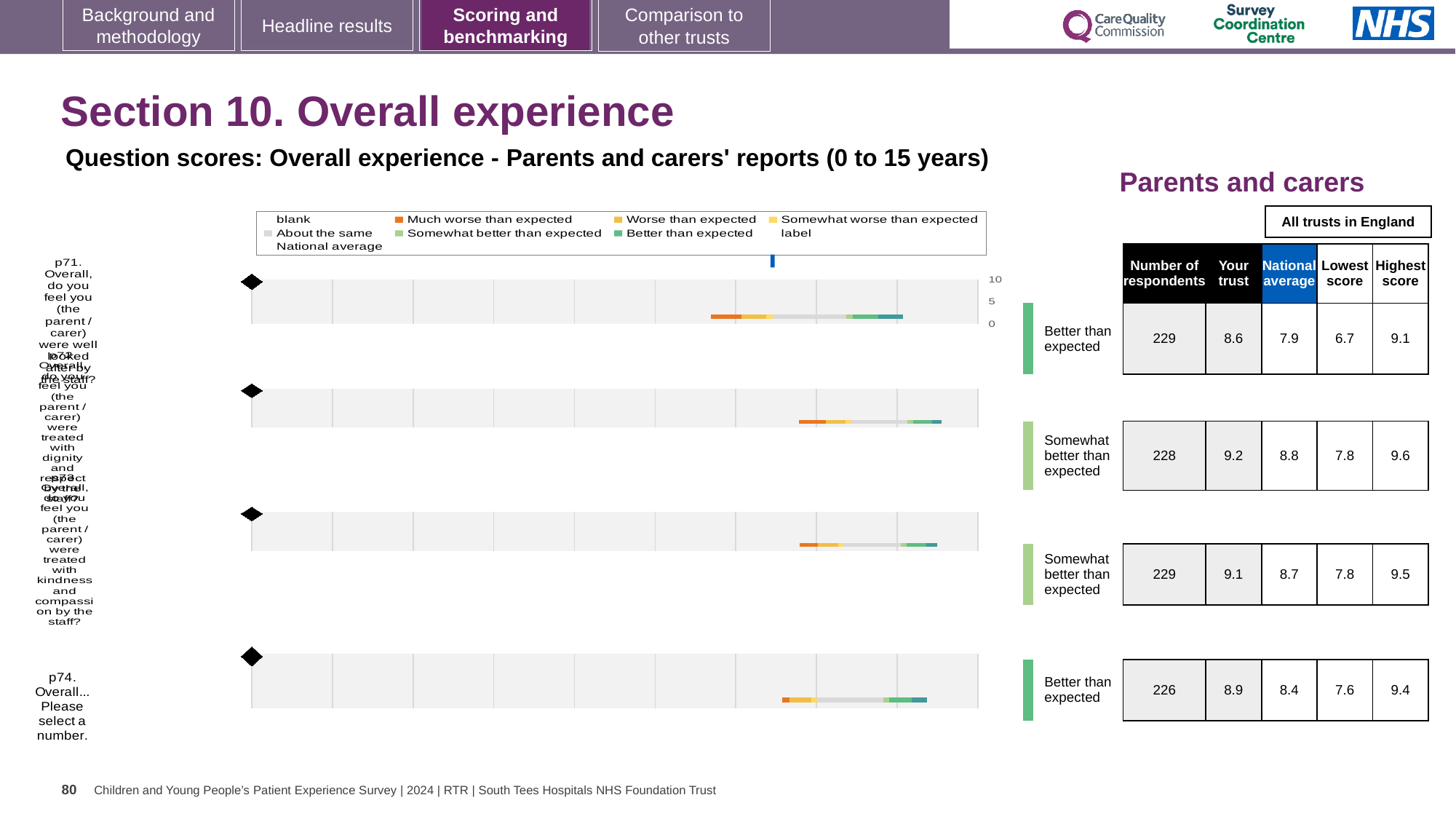
Which question has the lowest 'Your trust' score? p71 (well looked after by the staff), 8.6 What is the lowest score across all trusts for p74? 7.6 How many respondents answered p74 (Overall... Please select a number)? 226 What kind of chart is shown on the slide? bar chart What is the national average score for p71? 7.9 What is the difference between the 'Your trust' score and the national average for p71? 0.7 For p74, which is larger: the 'Your trust' score or the national average? Your trust (8.9) Which question has the highest 'Your trust' score? p72 (treated with dignity and respect), 9.2 How many questions (bars) are plotted in the chart? 4 What is the 'Your trust' score for p71 (Overall, do you feel you were well looked after by the staff?)? 8.6 What benchmark category is shown for p71? Better than expected What is the highest score across all trusts for the second question (treated with dignity and respect)? 9.6